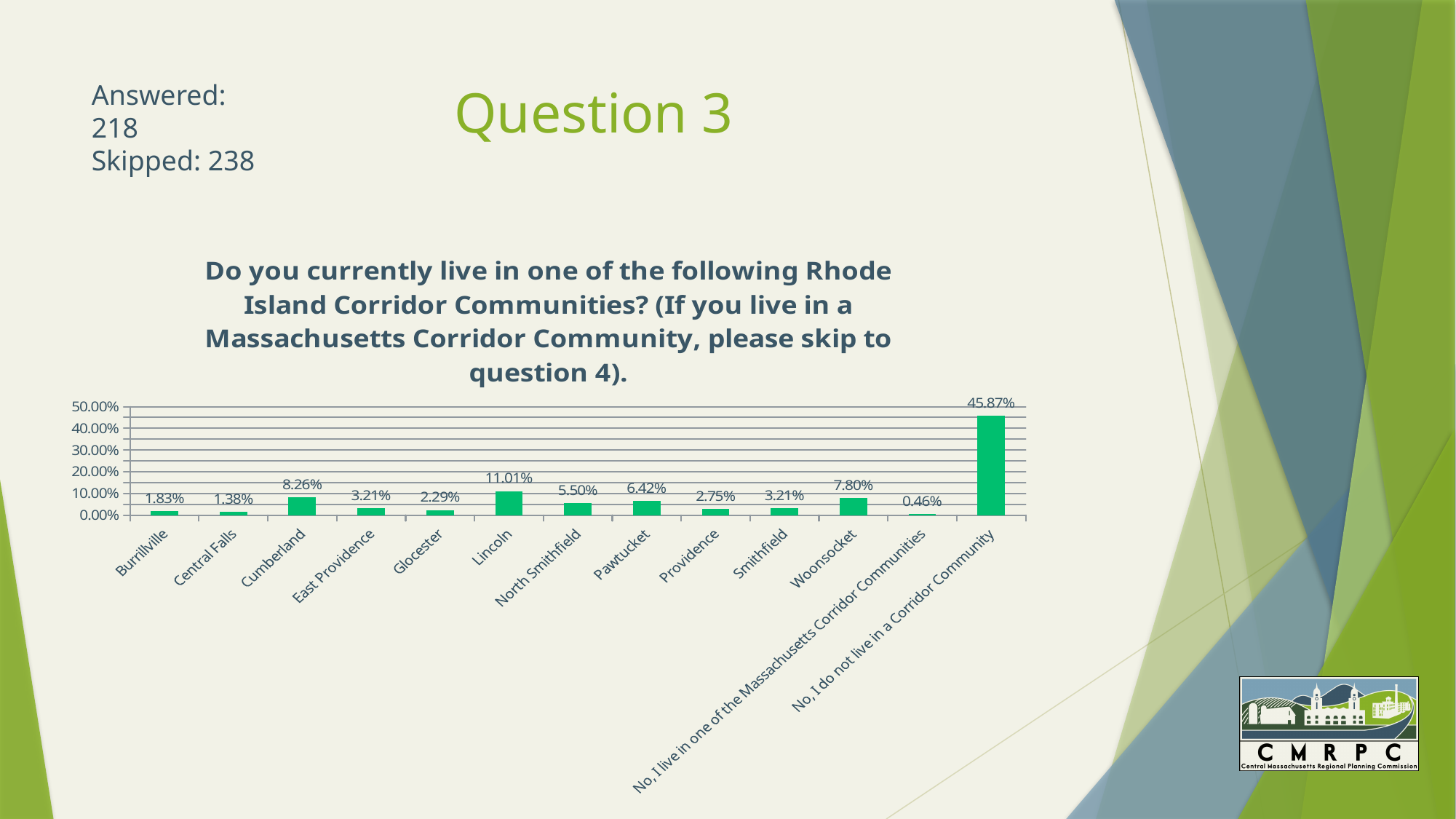
What kind of chart is shown on the slide? Bar chart What percentage of respondents live in Lincoln? 11.01% Is the value for Lincoln greater or less than 10.00%? greater How many categories are shown on the x axis of the chart? 13 What is the value shown for Woonsocket? 7.80% What is the difference between the values for Lincoln and Cumberland? 2.75% Which category has the lowest value in the chart? No, I live in one of the Massachusetts Corridor Communities Which category has the highest value in the chart? No, I do not live in a Corridor Community What percentage is shown for Central Falls? 1.38% What is the value for the category 'No, I do not live in a Corridor Community'? 45.87% Which has a larger value, Pawtucket or North Smithfield? Pawtucket What is the highest value shown on the y axis of the chart? 50.00%